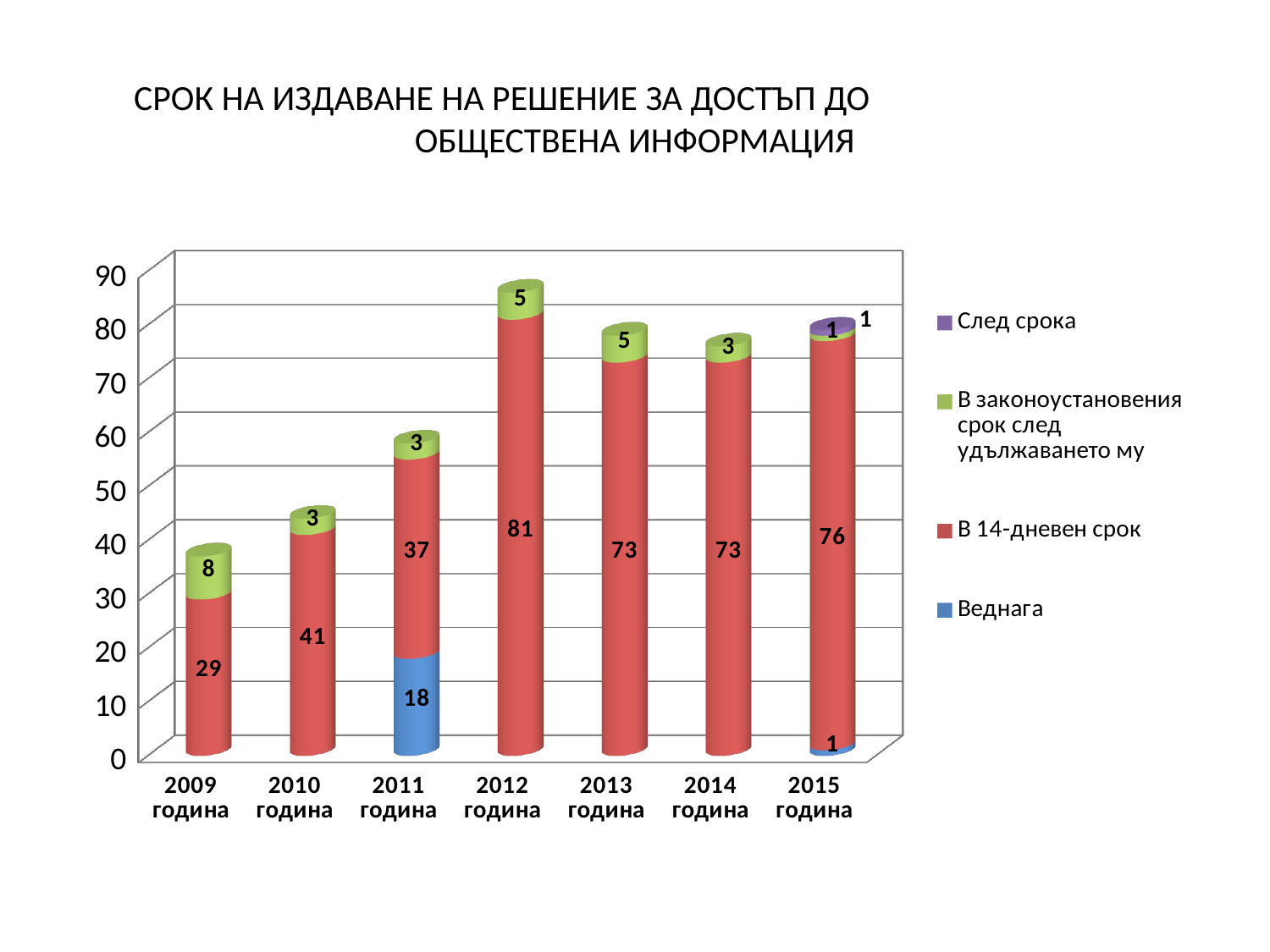
What is the total of the stacked bar for 2011 година? 58 What is the value for 'В 14-дневен срок' in 2012 година? 81 Which year has the lowest value for 'В 14-дневен срок'? 2009 година Which series is shown in purple in the legend? След срока What is the difference between the 'В 14-дневен срок' values for 2012 година and 2015 година? 5 What is the value for 'Веднага' in 2011 година? 18 How many series does the legend list? 4 How many years (categories) are shown on the x axis? 7 Which is larger: the 'В 14-дневен срок' value for 2010 година or for 2011 година? 2010 година What type of chart is shown on the slide? stacked bar chart Which year has the highest value for 'В 14-дневен срок'? 2012 година What is the value for 'В законоустановения срок след удължаването му' in 2009 година? 8